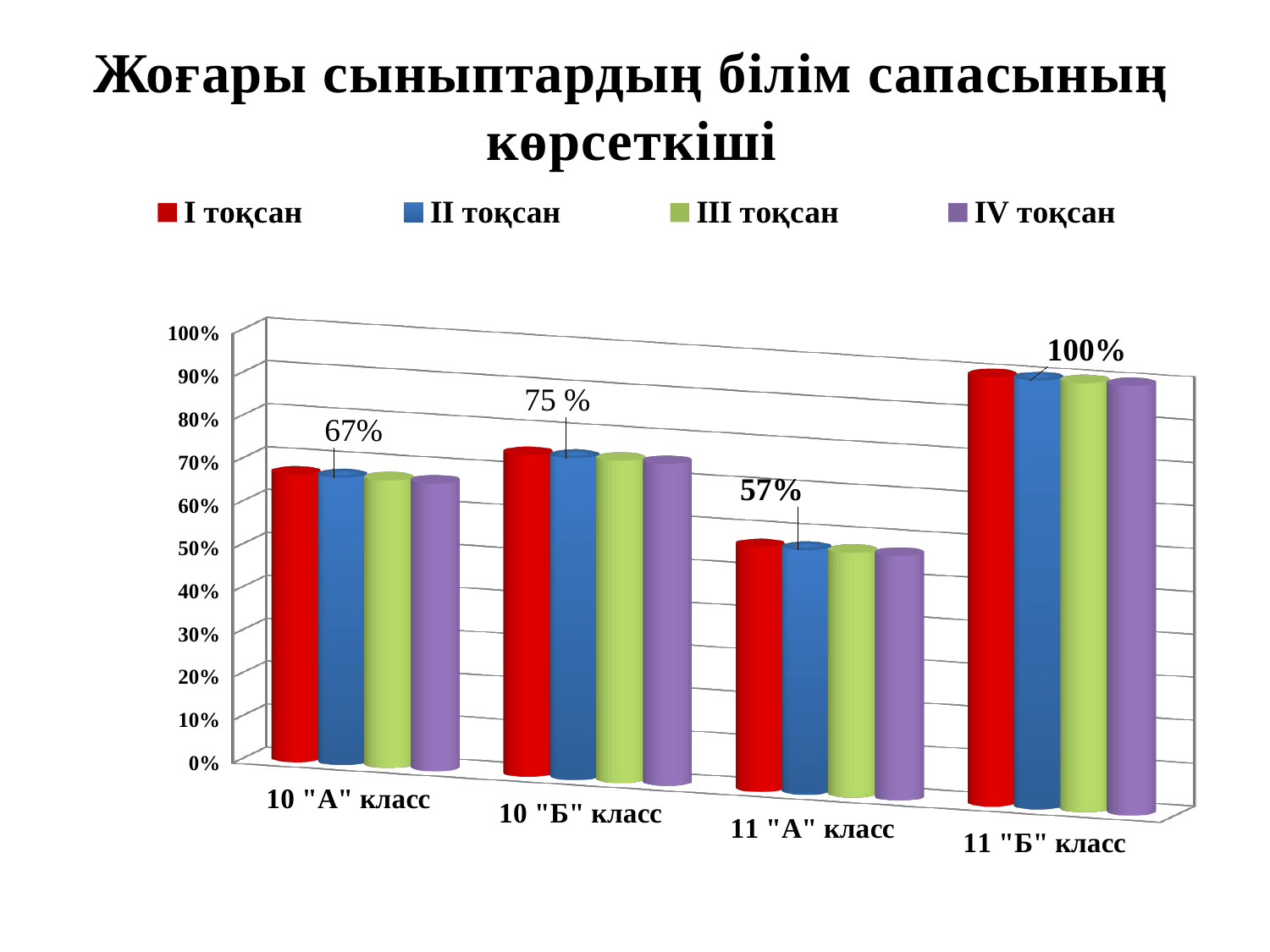
Which class has the lowest labelled value? 11 "А" класс What value is labelled for 11 "А" класс? 57% What value is labelled for 10 "А" класс? 67% Which has the larger labelled value, 10 "А" класс or 10 "Б" класс? 10 "Б" класс Which class has the highest labelled value? 11 "Б" класс What value is labelled for 10 "Б" класс? 75 % What is the difference between the labelled values for 11 "Б" класс and 11 "А" класс? 43% Which series is shown in red according to the legend? I тоқсан What kind of chart is shown on the slide? bar chart How many series does the legend list? 4 How many classes (categories) are shown on the x axis? 4 What value is labelled for 11 "Б" класс? 100%